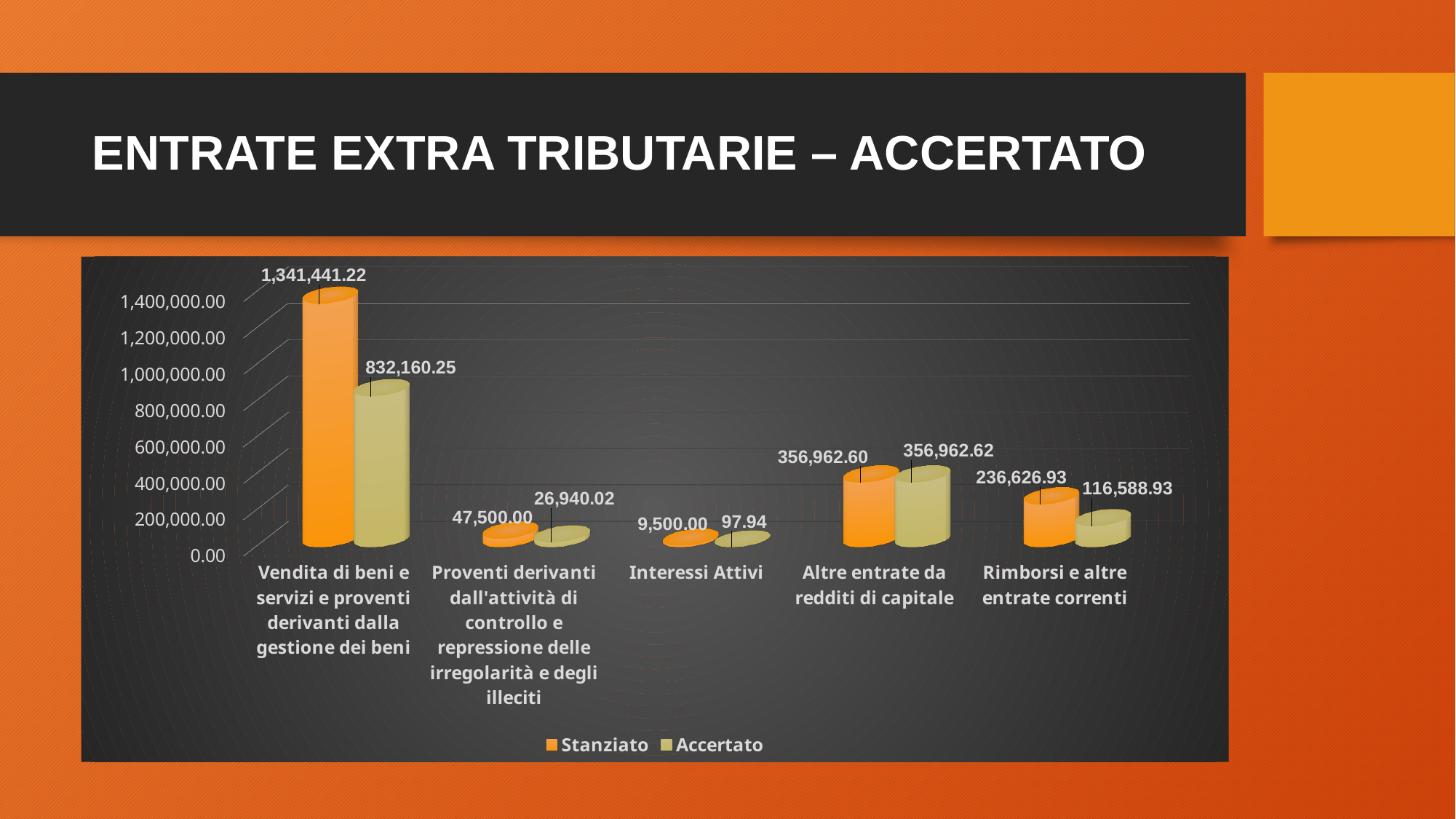
What is the Accertato value for Vendita di beni e servizi e proventi derivanti dalla gestione dei beni? 832,160.25 For Proventi derivanti dall'attività di controllo e repressione delle irregolarità e degli illeciti, which is larger, the Stanziato or the Accertato value? Stanziato What is the Accertato value for Rimborsi e altre entrate correnti? 116,588.93 What kind of chart is shown on the slide? Bar chart Which category has the highest Stanziato value? Vendita di beni e servizi e proventi derivanti dalla gestione dei beni Which category has the lowest Accertato value? Interessi Attivi How many categories are shown on the x axis of the chart? 5 How many series does the chart legend list? 2 What is the Stanziato value for Interessi Attivi? 9,500.00 What is the difference between the Stanziato and Accertato values for Rimborsi e altre entrate correnti? 120,038.00 What is the Stanziato value for Altre entrate da redditi di capitale? 356,962.60 What is the difference between the Stanziato and Accertato values for Vendita di beni e servizi e proventi derivanti dalla gestione dei beni? 509,280.97